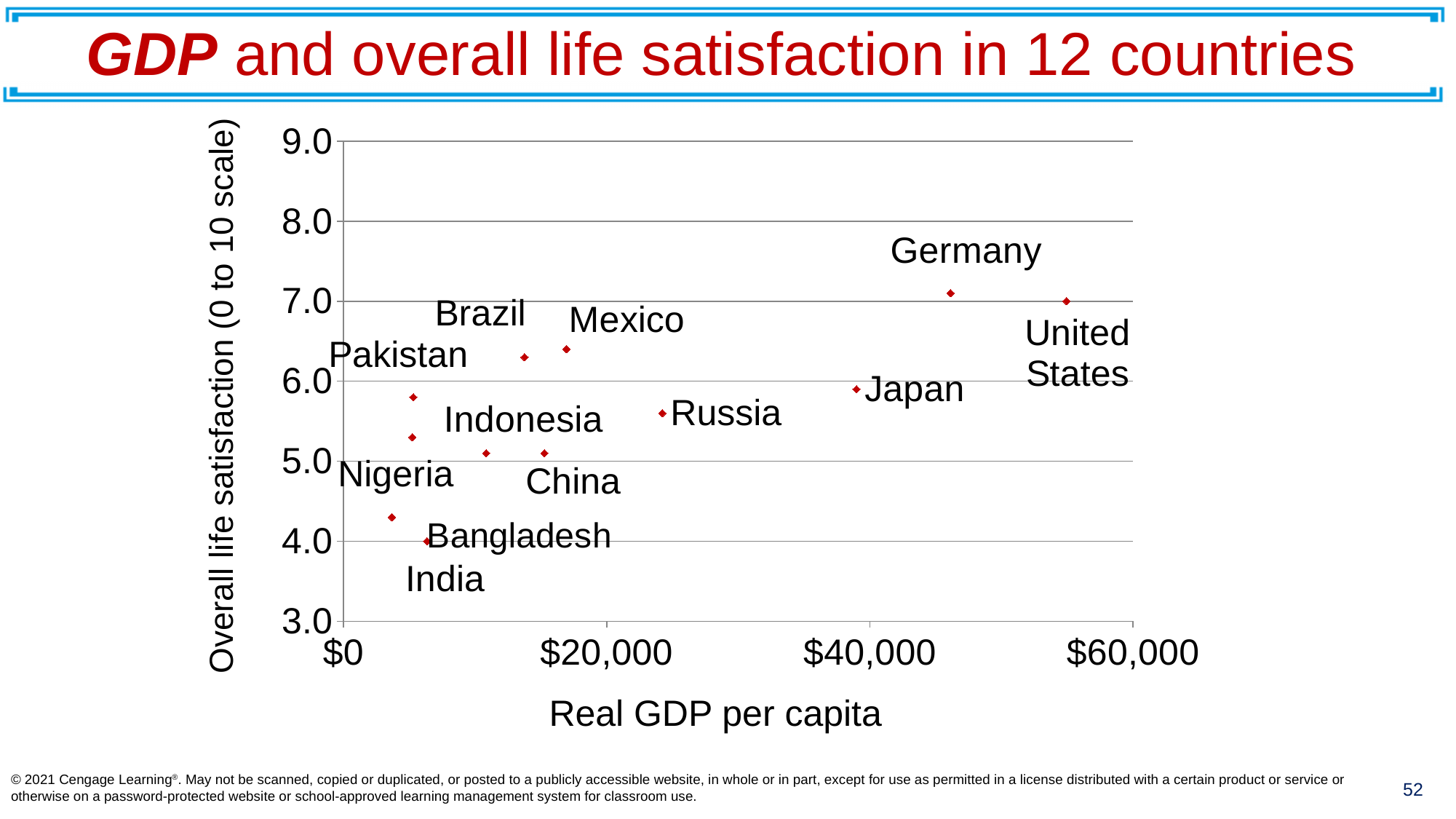
Is the overall life satisfaction value for Russia greater or less than 6.0? less Is the overall life satisfaction value for China greater or less than 6.0? less How many countries are plotted on the chart? 12 Which has higher overall life satisfaction, Germany or China? Germany Which country has the highest real GDP per capita on the chart? United States What is the label of the horizontal axis? Real GDP per capita Does overall life satisfaction generally rise or fall as real GDP per capita increases? rise Is the real GDP per capita for Germany greater or less than $40,000? greater What kind of chart is shown on the slide? scatter chart